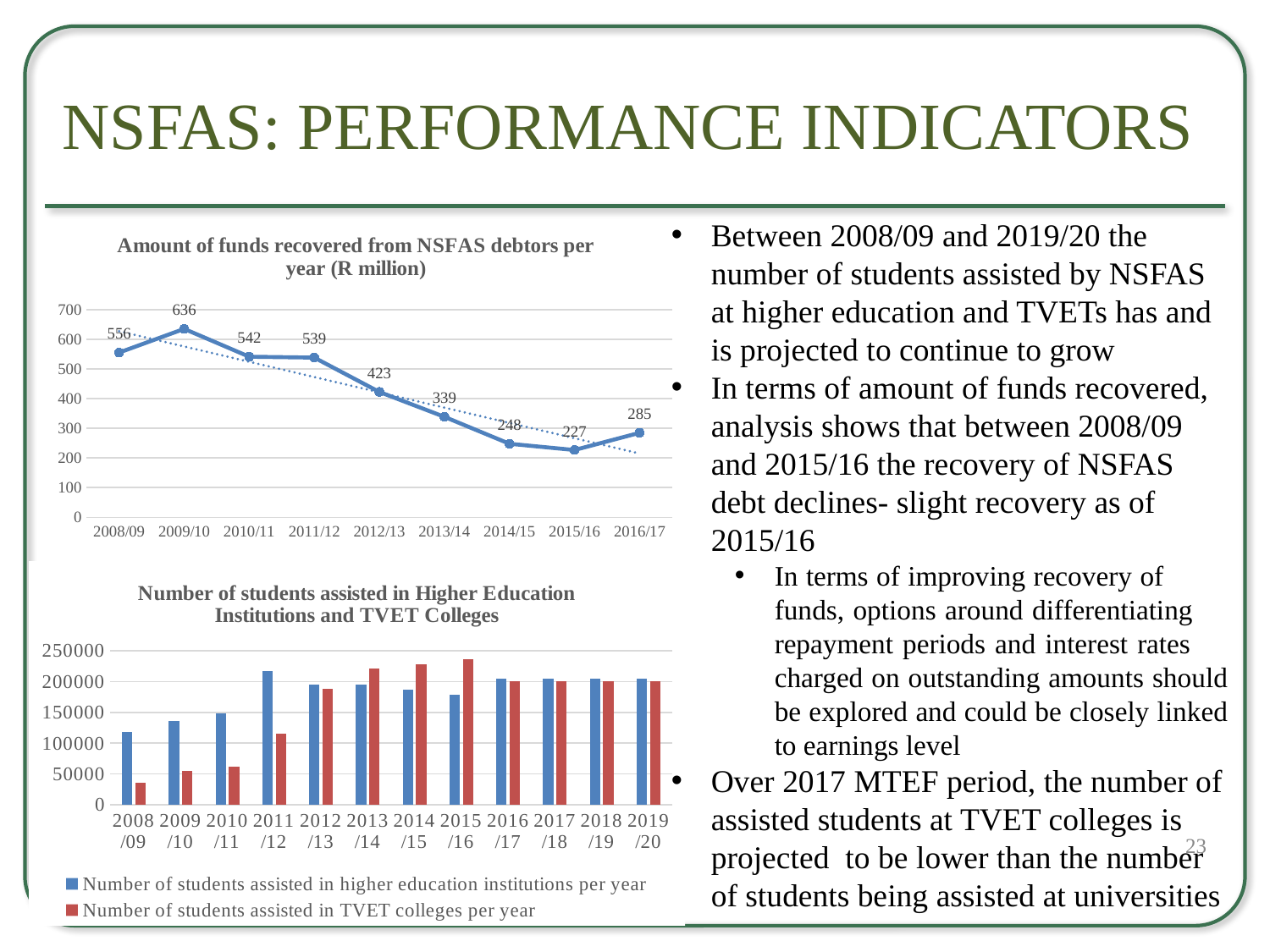
In the chart 'Amount of funds recovered from NSFAS debtors per year (R million)', is the value for 2012/13 or 2013/14 larger? 2012/13 In the chart 'Amount of funds recovered from NSFAS debtors per year (R million)', which year has the highest value? 2009/10 In the chart 'Number of students assisted in Higher Education Institutions and TVET Colleges', is the number of students assisted in TVET colleges in 2008/09 greater or less than 50000? less In the chart 'Amount of funds recovered from NSFAS debtors per year (R million)', which year has the lowest value? 2015/16 How many years are plotted in the chart 'Amount of funds recovered from NSFAS debtors per year (R million)'? 9 In the chart 'Amount of funds recovered from NSFAS debtors per year (R million)', what is the difference between the 2008/09 value and the 2016/17 value? 271 In the chart 'Number of students assisted in Higher Education Institutions and TVET Colleges', is the number of students assisted in TVET colleges in 2015/16 greater or less than 200000? greater What kind of chart is 'Amount of funds recovered from NSFAS debtors per year (R million)'? Line chart In the chart 'Amount of funds recovered from NSFAS debtors per year (R million)', what was the amount recovered in 2015/16? 227 In the chart 'Amount of funds recovered from NSFAS debtors per year (R million)', do the values generally rise or fall from 2009/10 to 2015/16? Fall In the chart 'Amount of funds recovered from NSFAS debtors per year (R million)', what was the amount recovered in 2009/10? 636 How many series does the legend list in the chart 'Number of students assisted in Higher Education Institutions and TVET Colleges'? 2